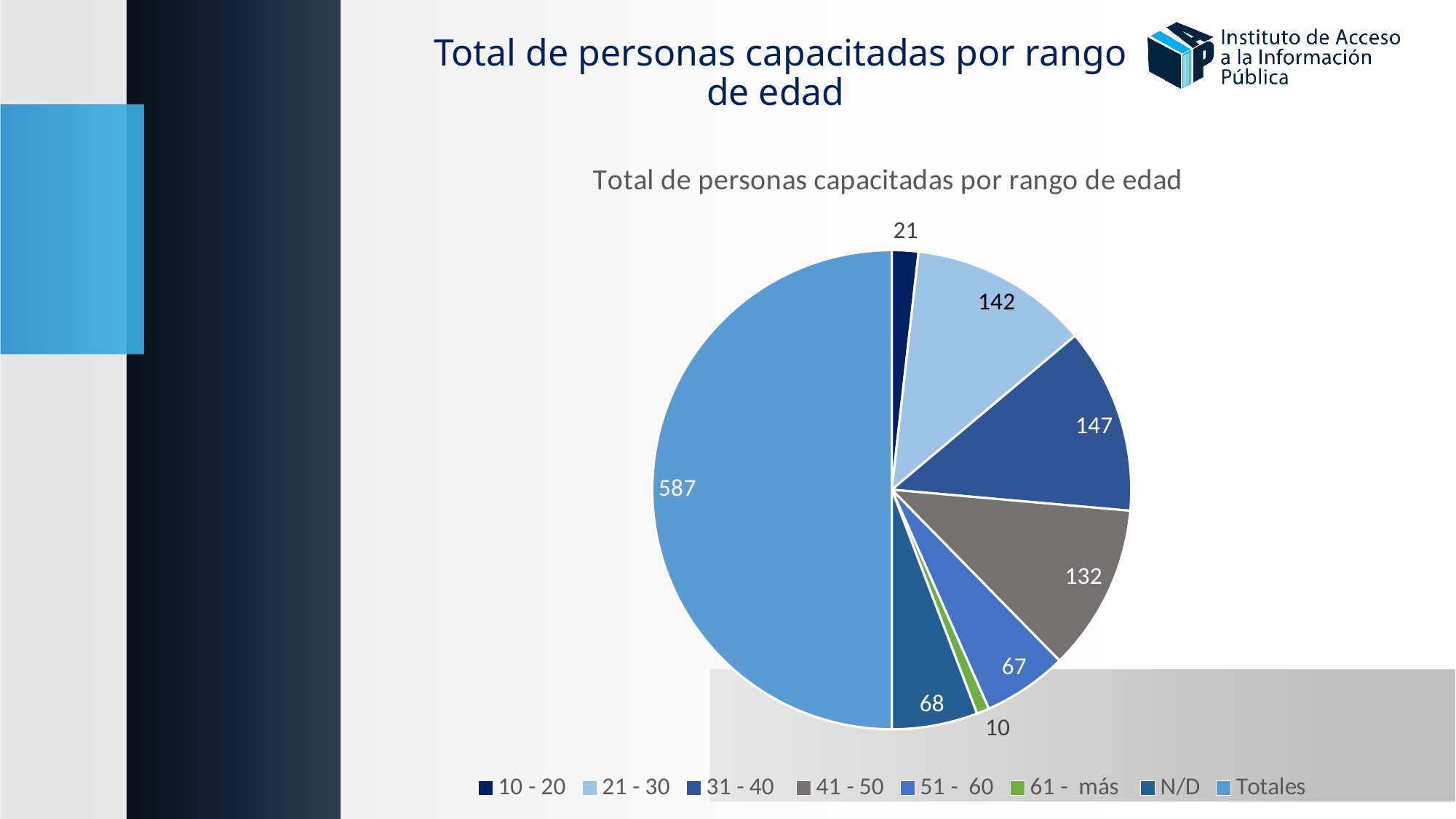
What is the title of the chart? Total de personas capacitadas por rango de edad Which category has the smallest slice? 61 - más How many slices does the pie chart have? 8 Which is larger, the value for 51 - 60 or the value for N/D? N/D What is the difference between the 21 - 30 value and the 41 - 50 value? 10 What is the value for the 31 - 40 slice? 147 What share of the pie does the Totales slice represent? 50% What is the difference between the 31 - 40 value and the 21 - 30 value? 5 What kind of chart is shown on the slide? pie chart Which category has the largest slice? Totales What is the value for the N/D slice? 68 What is the value for the 61 - más slice? 10